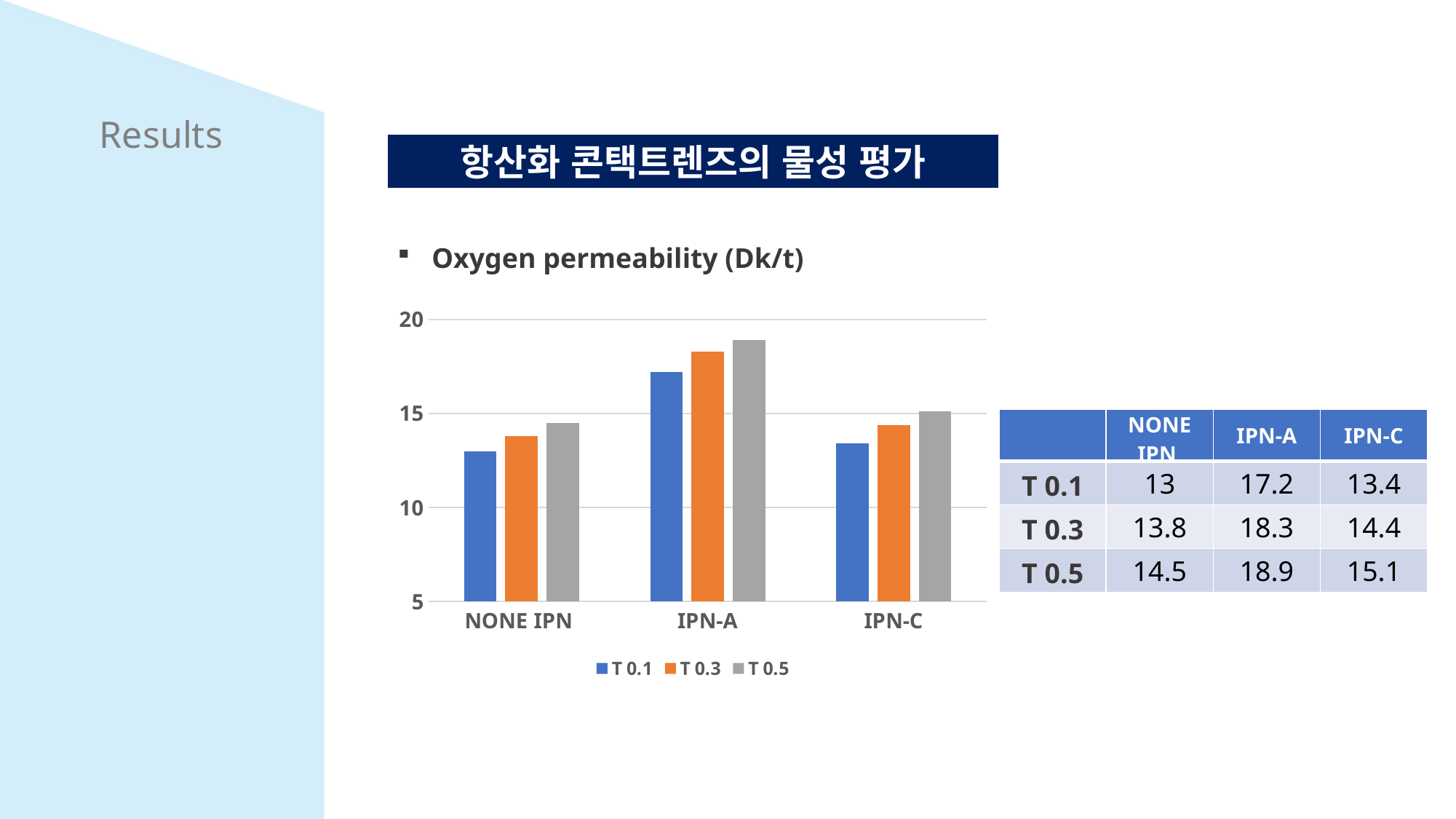
What is the difference between the T 0.5 and T 0.1 values for IPN-A? 1.7 Which category has the lowest oxygen permeability in the T 0.1 series? NONE IPN Is the T 0.1 value for IPN-A greater or less than 15? greater Which colour represents the T 0.3 series in the chart? orange What is the oxygen permeability value for NONE IPN in the T 0.5 series? 14.5 Which is larger, the T 0.3 value for NONE IPN or the T 0.3 value for IPN-C? IPN-C How many categories are shown on the x axis of the chart? 3 What is the oxygen permeability value for IPN-A in the T 0.1 series? 17.2 What kind of chart is shown on the slide? bar chart Which category has the highest oxygen permeability in the T 0.5 series? IPN-A How many series does the chart legend list? 3 What is the oxygen permeability value for IPN-C in the T 0.3 series? 14.4